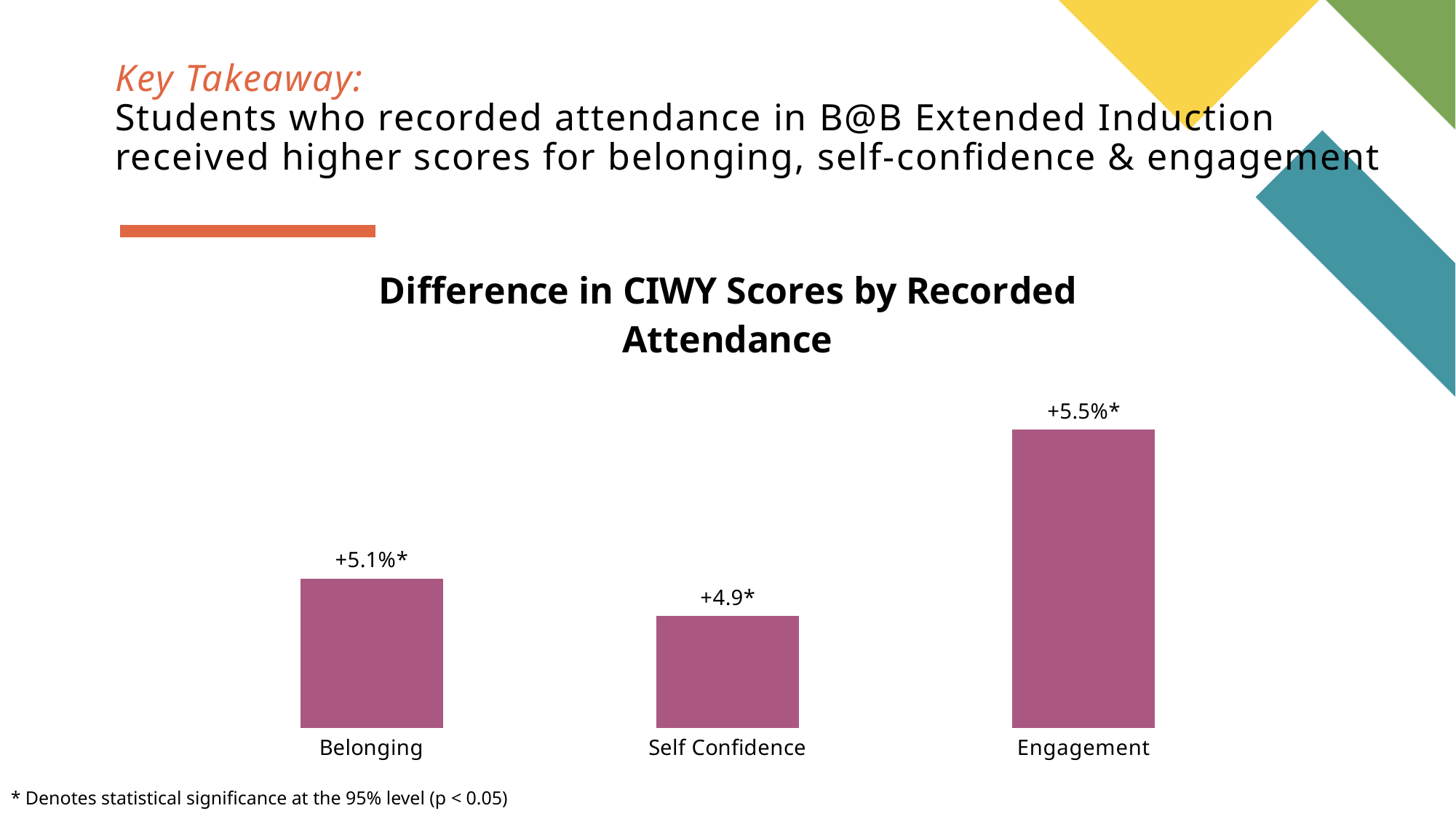
Which category has the lowest value? Self Confidence Do the values rise or fall from Self Confidence to Engagement? Rise Which is larger, the value for Belonging or the value for Engagement? Engagement How many categories are shown on the chart? 3 What is the data label shown for Self Confidence? +4.9* What is the difference between the Engagement value (+5.5%) and the Belonging value (+5.1%)? 0.4% What is the data label shown for Engagement? +5.5%* Which is larger, the value for Belonging or the value for Self Confidence? Belonging Which category has the highest value? Engagement What is the title of the chart? Difference in CIWY Scores by Recorded Attendance What is the data label shown for Belonging? +5.1%* What kind of chart is shown on the slide? Bar chart